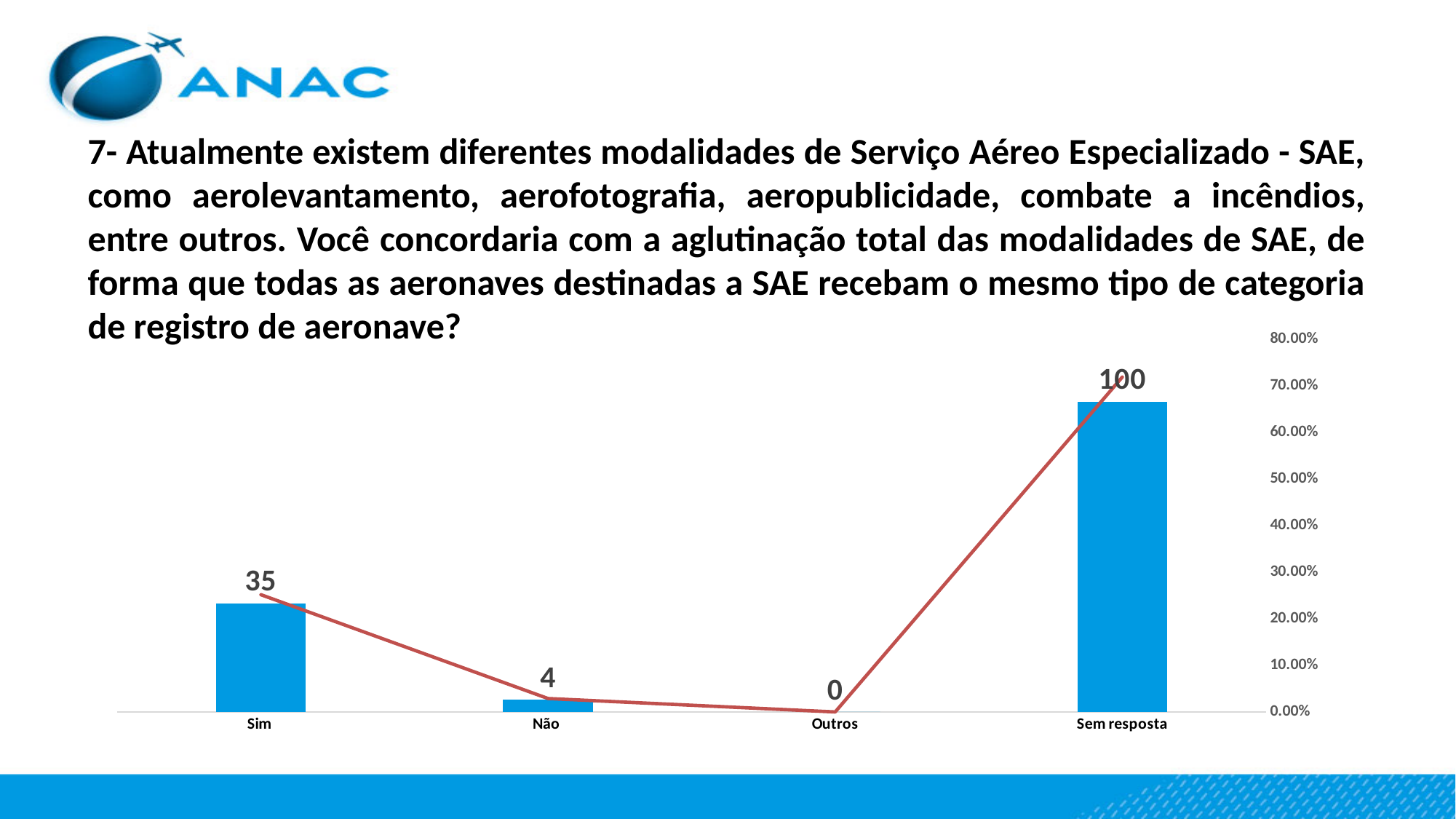
How many categories are shown on the x axis? 4 Which category has the highest value? Sem resposta What is the sum of the four labelled values (35, 4, 0 and 100)? 139 Is the bar for "Sem resposta" greater or less than 60.00% on the right-hand axis? greater What is the data label shown for the "Não" category? 4 Which category has the lowest value? Outros What is the data label shown for the "Sim" category? 35 What is the data label shown for the "Outros" category? 0 Which is larger, the value for "Sim" or the value for "Não"? Sim Is the bar for "Sim" greater or less than 30.00% on the right-hand axis? less What is the data label shown for the "Sem resposta" category? 100 What is the difference between the labelled values for "Sem resposta" and "Sim"? 65